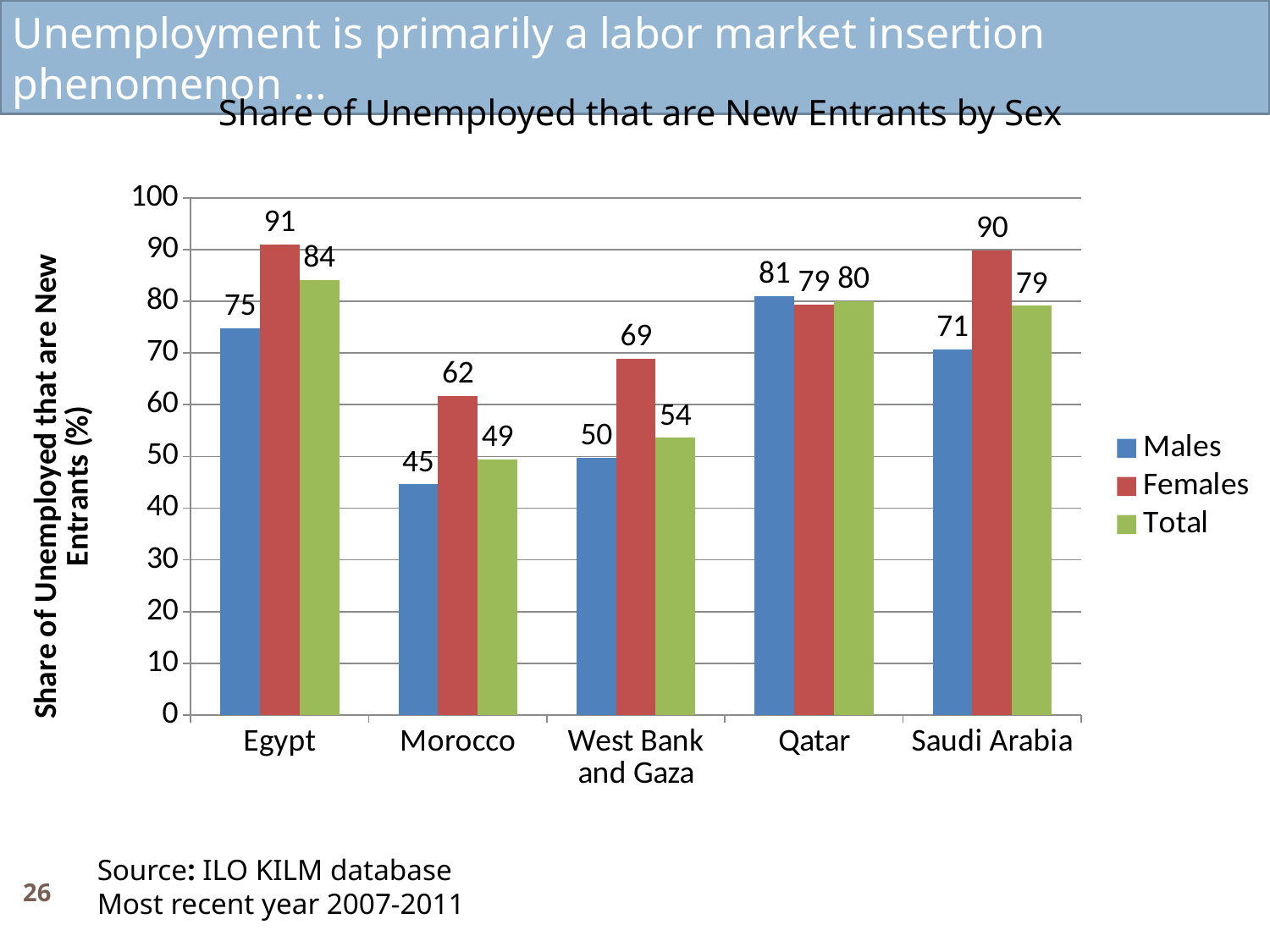
What is the difference between the Females and Males values for Saudi Arabia? 19 How many countries are shown on the x axis? 5 Which country has the highest Females value? Egypt How many series does the legend list? 3 Which country has the lowest Males value? Morocco What is the Males value for Morocco? 45 Is the Total value for Morocco greater or less than 50? less Which is larger for Qatar, the Males value or the Females value? Males What is the Total value for West Bank and Gaza? 54 What is the title of the chart? Share of Unemployed that are New Entrants by Sex What kind of chart is shown? Bar chart What is the Females value for Egypt? 91